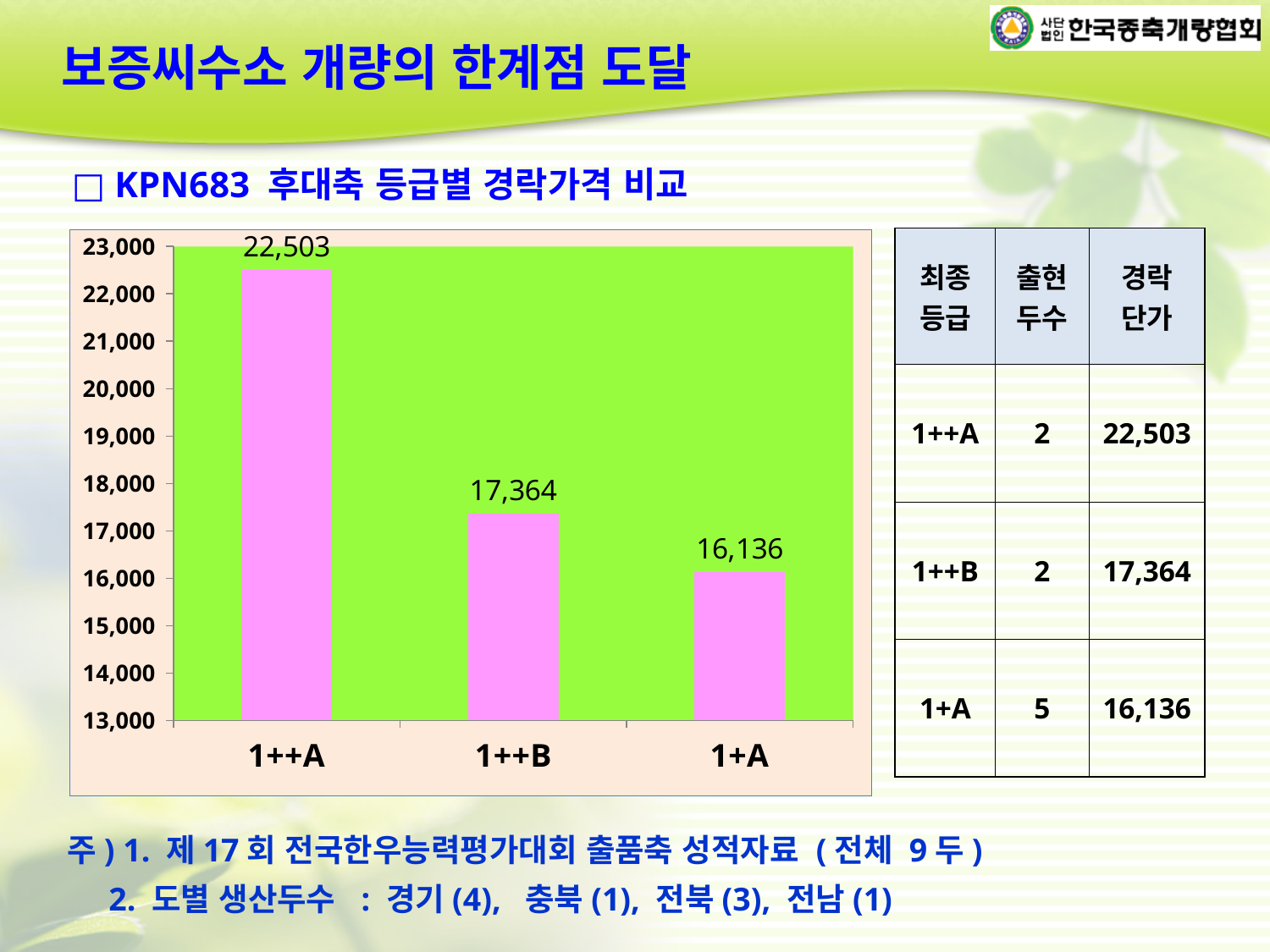
How many categories are shown on the x axis? 3 Which category has the lowest value? 1+A Do the values rise or fall from left to right along the x axis? fall Which is larger, the value for 1++B or the value for 1+A? 1++B What is the difference between the values for 1++A and 1++B? 5,139 Is the value for 1++A greater or less than 20,000? greater Which category has the highest value? 1++A What is the difference between the values for 1++B and 1+A? 1,228 What is the value for 1++B? 17,364 What is the value for 1+A? 16,136 What is the value for 1++A? 22,503 What kind of chart is shown? bar chart